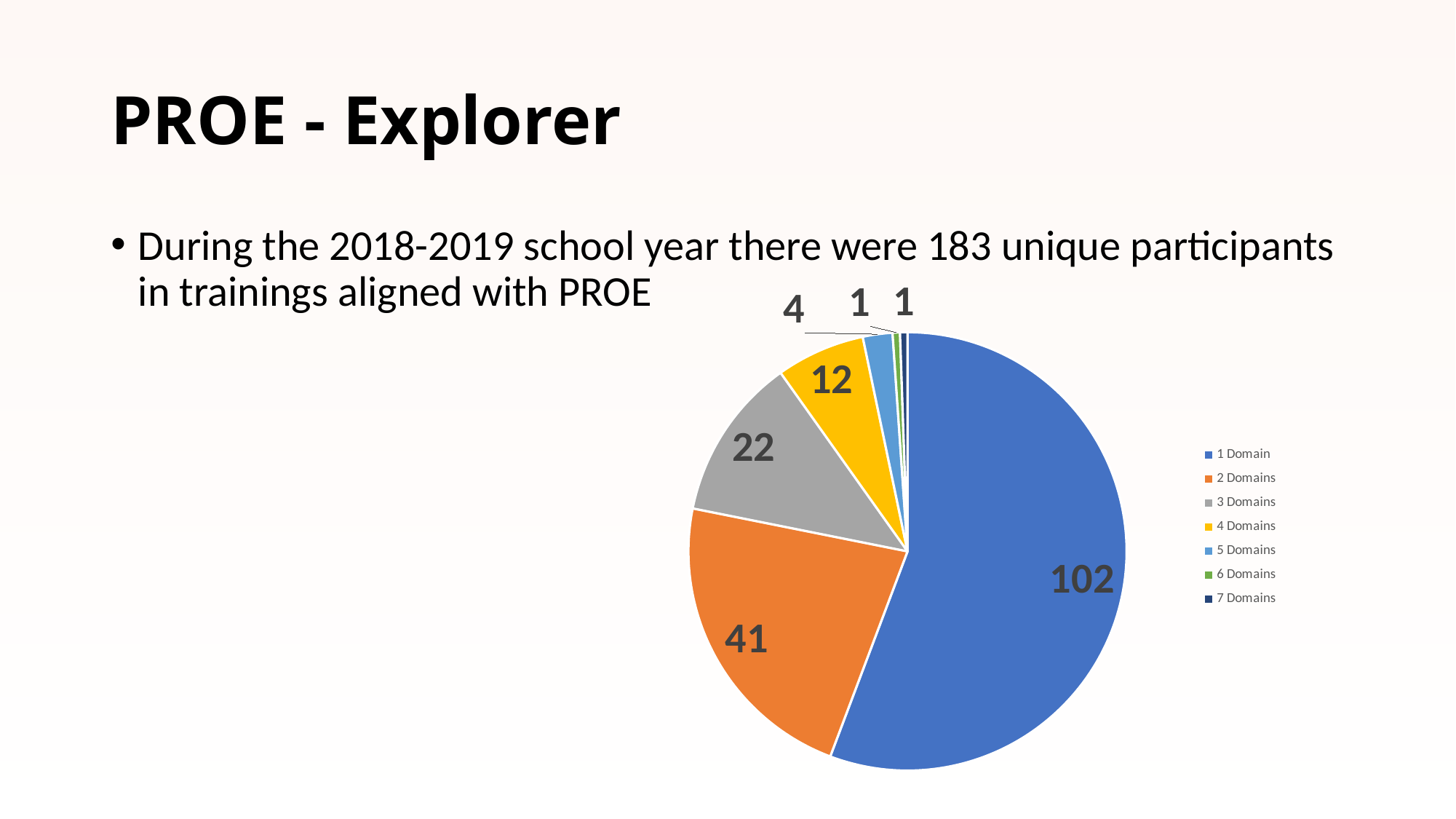
What is the value for 4 Domains? 12 Which is larger, the value for 3 Domains or the value for 4 Domains? 3 Domains What colour is the 4 Domains slice? Yellow What is the difference between the values for 1 Domain and 2 Domains? 61 Which category has the largest slice of the pie? 1 Domain What is the value for 3 Domains? 22 What is the value for 5 Domains? 4 Which two categories share the smallest value in the pie chart? 6 Domains and 7 Domains What is the value for 2 Domains? 41 How many participants are in the 1 Domain slice? 102 What kind of chart is shown on the slide? Pie chart How many categories does the legend of the pie chart list? 7